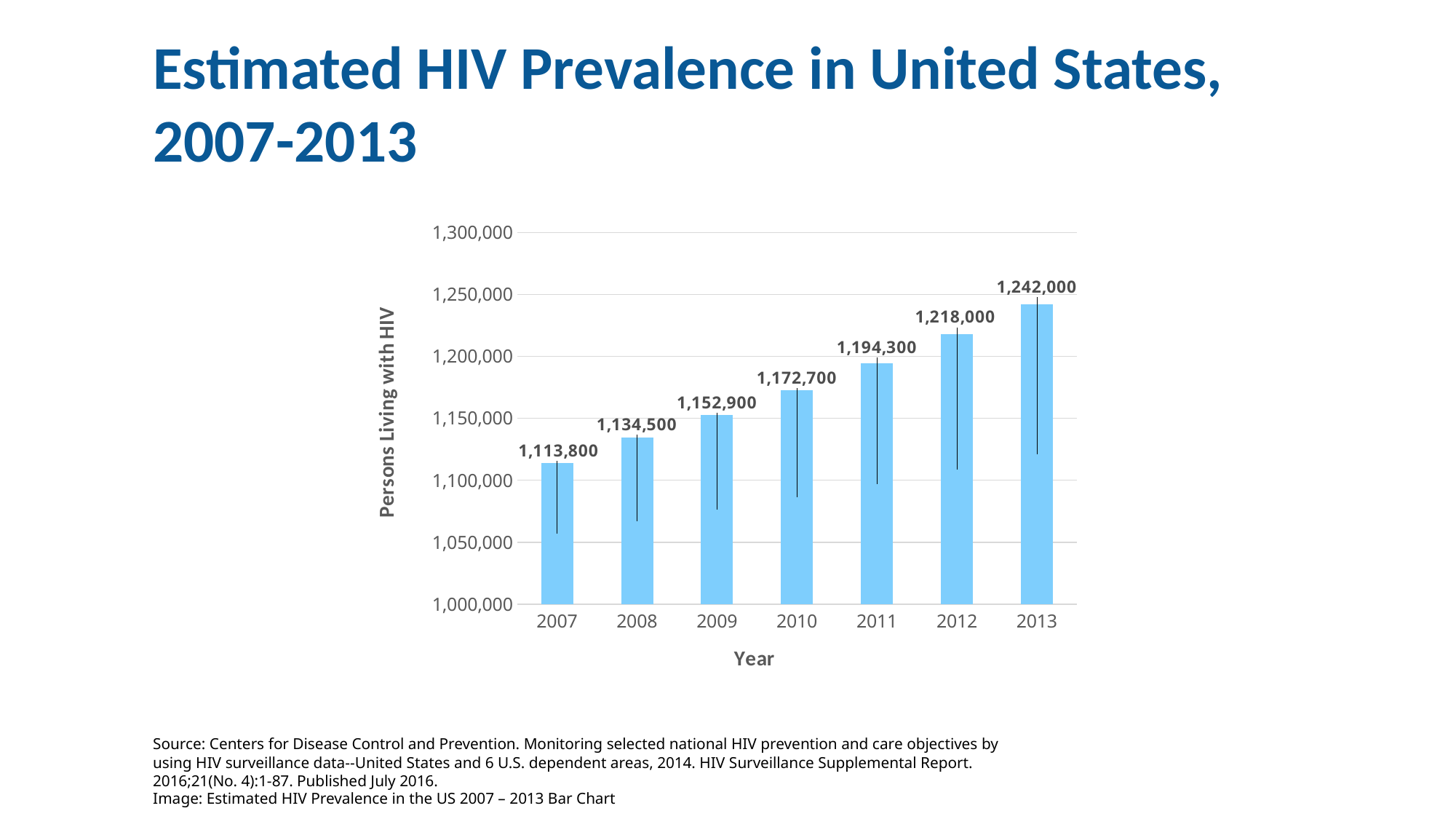
What is the difference between the values for 2013 and 2007? 128,200 Which year has the highest estimated HIV prevalence? 2013 Do the values rise or fall from 2007 to 2013? rise Which year has the lowest estimated HIV prevalence? 2007 How many years are shown on the x axis? 7 What is the value shown for 2012? 1,218,000 What kind of chart is shown on the slide? bar chart Which year has a larger value, 2011 or 2009? 2011 What is the difference between the values for 2009 and 2008? 18,400 What is the estimated number of persons living with HIV in 2007? 1,113,800 What is the estimated number of persons living with HIV in 2010? 1,172,700 Is the value for 2011 greater or less than 1,200,000? less